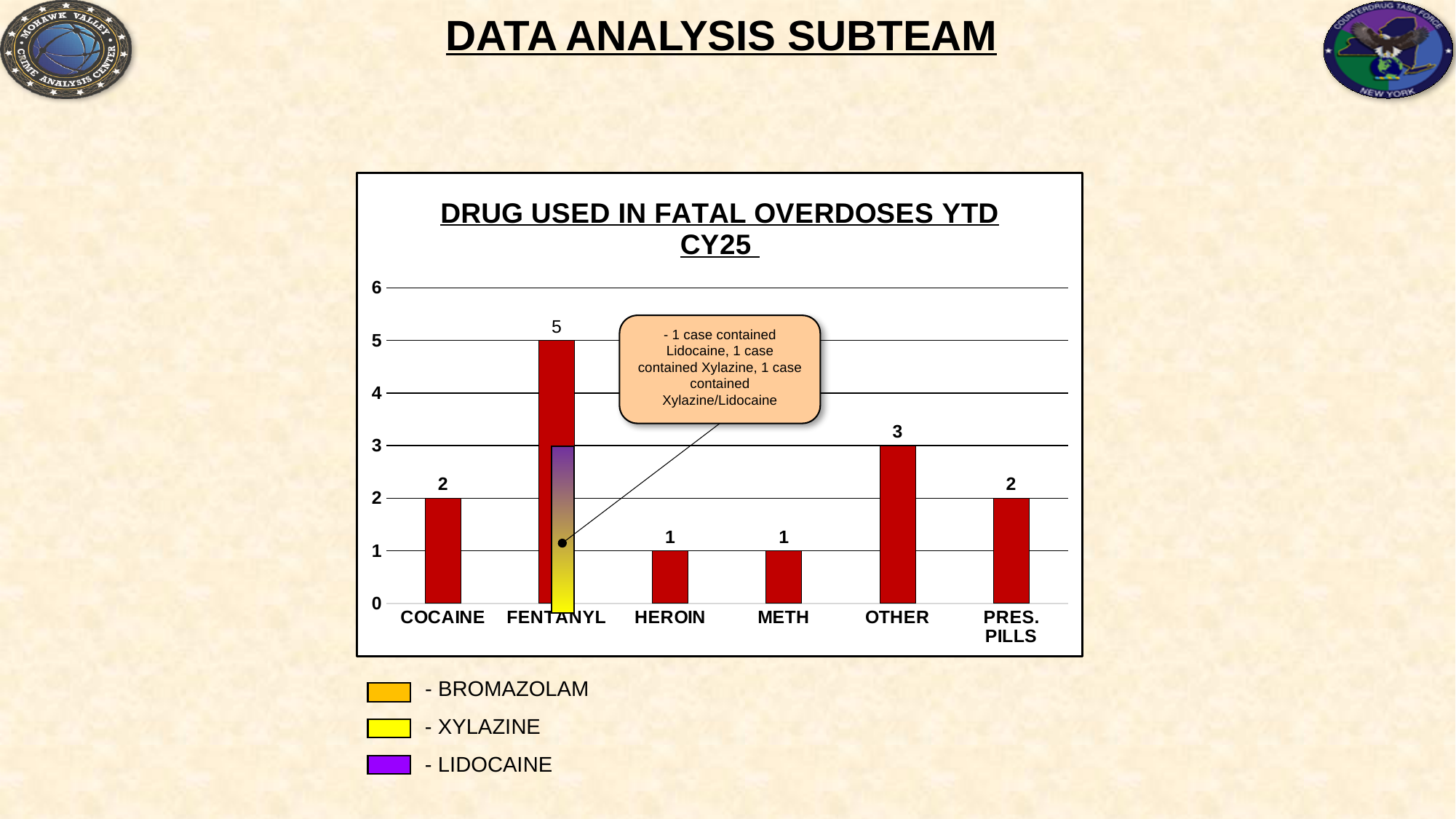
What is the title of the chart? DRUG USED IN FATAL OVERDOSES YTD CY25 What kind of chart is shown on the slide? bar chart Which category has the highest value? FENTANYL Which is larger, the value for OTHER or the value for PRES. PILLS? OTHER What is the value for OTHER in the chart? 3 How many categories are shown on the x axis? 6 What is the value for COCAINE in the chart? 2 Is the value for FENTANYL greater or less than 4? greater What is the value for FENTANYL in the chart? 5 According to the legend below the chart, which substance is represented by the yellow colour? XYLAZINE What is the value for HEROIN in the chart? 1 What is the difference between the values for FENTANYL and OTHER? 2